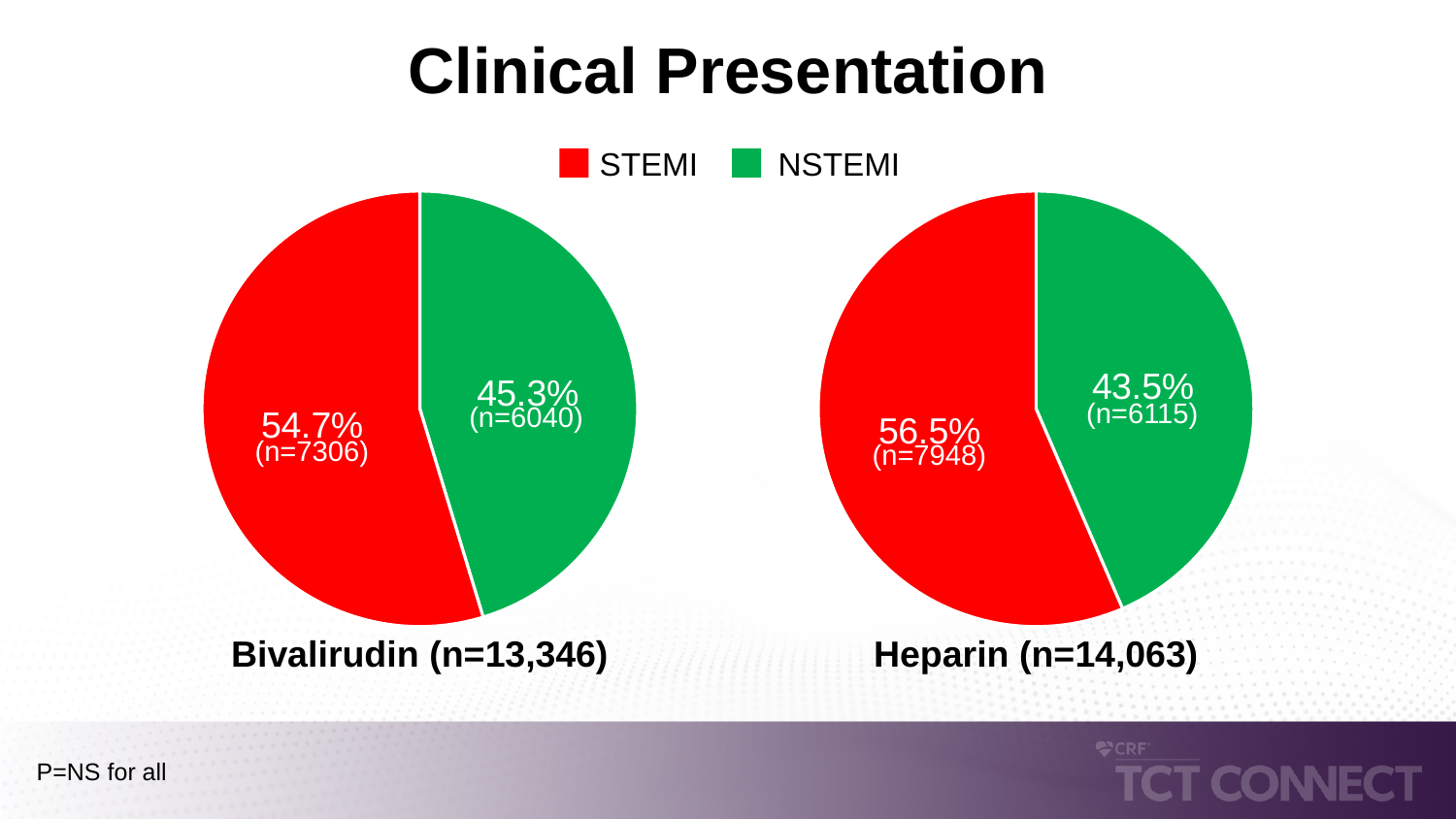
In the Bivalirudin pie chart, what is the difference in percentage points between the STEMI and NSTEMI slices? 9.4 percentage points How many series does the legend list? 2 What is the total number of patients shown for the Heparin pie chart? n=14,063 In the Heparin pie chart, what percentage of patients had NSTEMI? 43.5% In the Heparin pie chart, how many patients had STEMI? n=7948 In the Bivalirudin pie chart, how many patients had NSTEMI? n=6040 In the Heparin pie chart, what percentage of patients had STEMI? 56.5% In the Bivalirudin pie chart, what percentage of patients had STEMI? 54.7% What kind of charts are shown on the slide? Pie charts What colour represents NSTEMI in the pie charts? Green In the Bivalirudin pie chart, what percentage of patients had NSTEMI? 45.3% In the Heparin pie chart, which slice is larger, STEMI or NSTEMI? STEMI